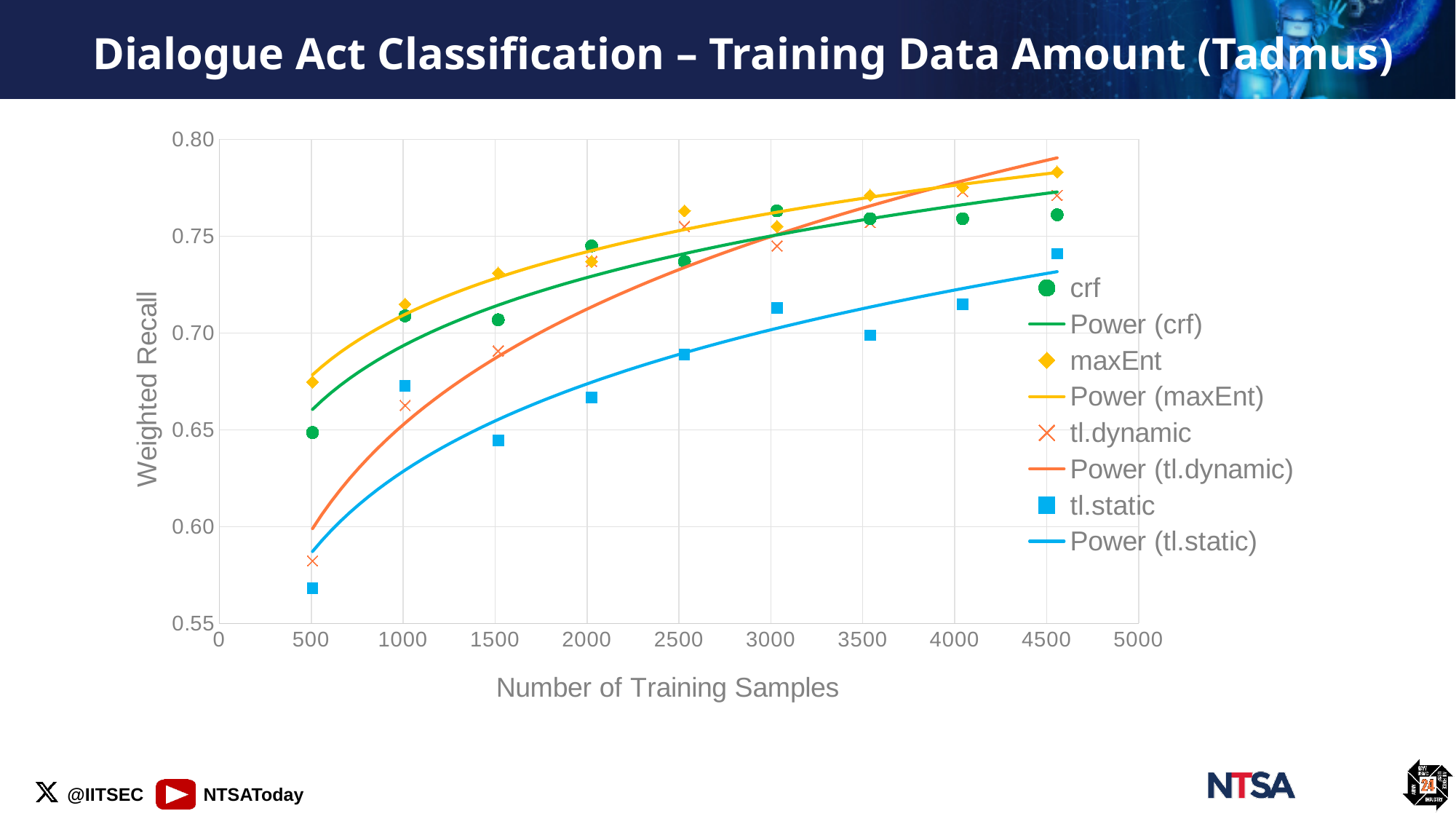
Which series has the lowest weighted recall at 500 training samples? tl.static Is the maxEnt value at 500 training samples greater or less than 0.65? greater Is the tl.static value at 500 training samples greater or less than 0.60? less Is the tl.static value at about 2500 training samples greater or less than 0.70? less Do the weighted recall values generally rise or fall as the number of training samples increases? rise How many data points are plotted for the tl.static series? 9 How many entries does the chart legend list? 8 What is the title of the vertical axis? Weighted Recall What kind of chart is shown on the slide? Scatter chart with trendlines At 500 training samples, which series has the higher weighted recall, maxEnt or tl.static? maxEnt